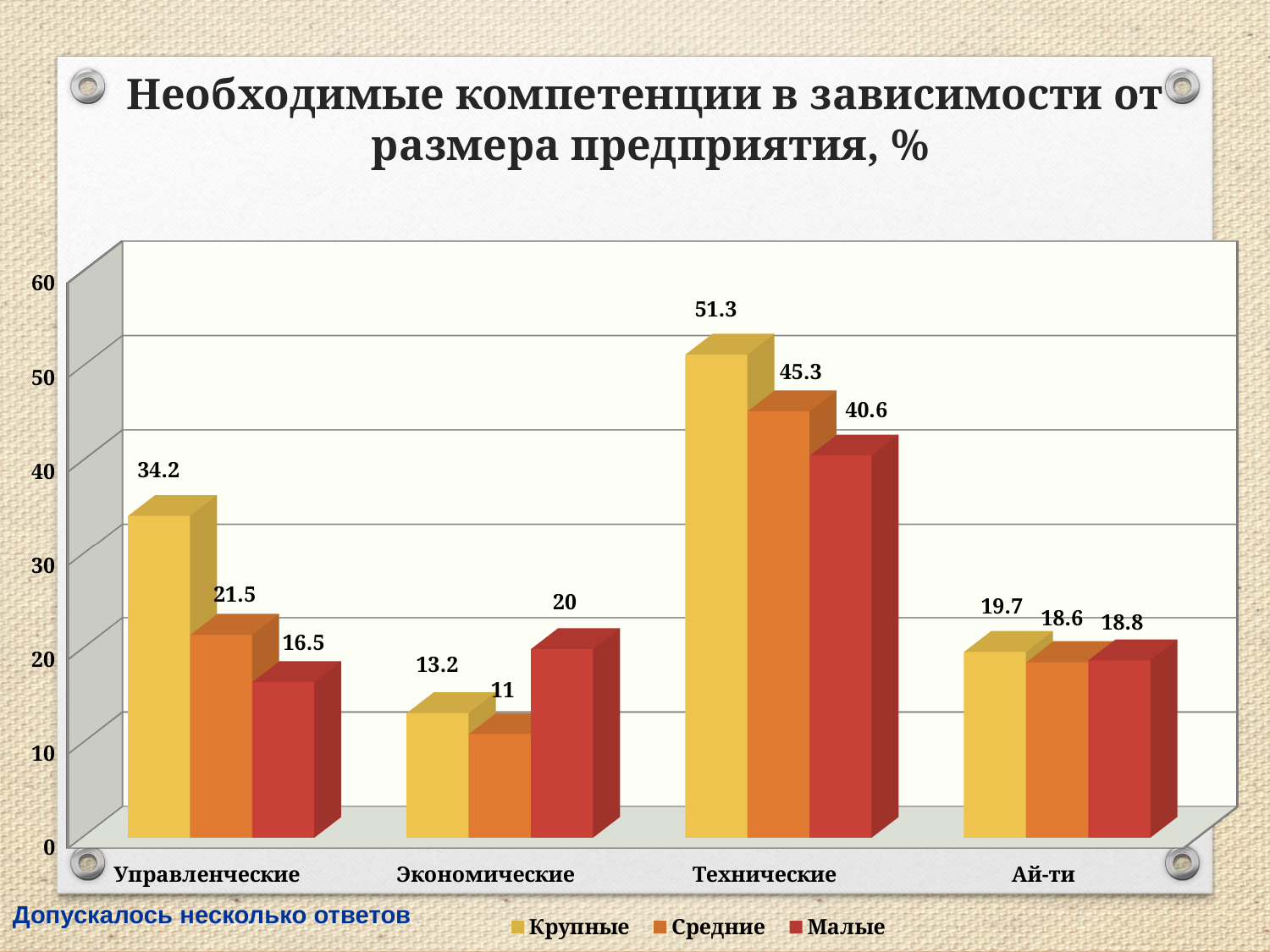
What kind of chart is shown on the slide? Bar chart What is the value for Крупные in the Технические category? 51.3 Which category has the lowest value for the Средние series? Экономические Which category has the highest value for the Крупные series? Технические What is the difference between the Средние and Малые values in the Технические category? 4.7 What are the three series listed in the legend? Крупные, Средние, Малые What is the difference between the Крупные and Малые values in the Управленческие category? 17.7 Which is larger in the Экономические category: the value for Крупные or for Малые? Малые How many series does the legend list? 3 What is the value for Средние in the Управленческие category? 21.5 What is the value for Малые in the Экономические category? 20 How many categories are shown on the x axis? 4